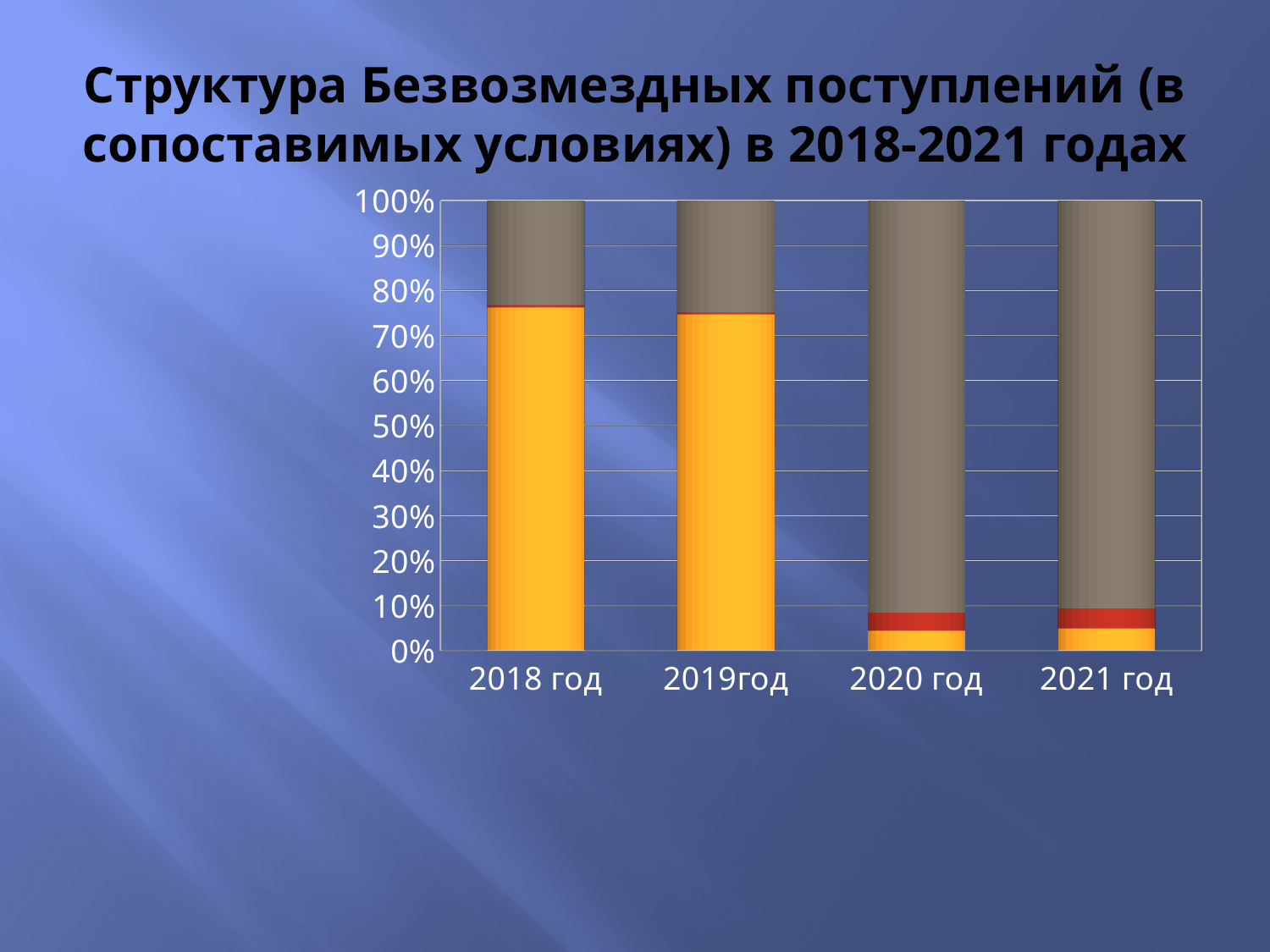
Does the share of the yellow segment rise or fall from 2018 год to 2021 год? fall Is the grey segment for 2020 год greater or less than 80%? greater Is the yellow segment for 2018 год greater or less than 70%? greater What kind of chart is shown on the slide? Stacked bar chart Which year has the largest yellow segment? 2018 год Is the yellow segment for 2019год greater or less than 70%? greater What is the title of the chart on the slide? Структура Безвозмездных поступлений (в сопоставимых условиях) в 2018-2021 годах How many years (categories) are shown on the x axis of the chart? 4 Which is larger, the yellow segment for 2018 год or for 2020 год? 2018 год What is the highest value shown on the vertical axis of the chart? 100%